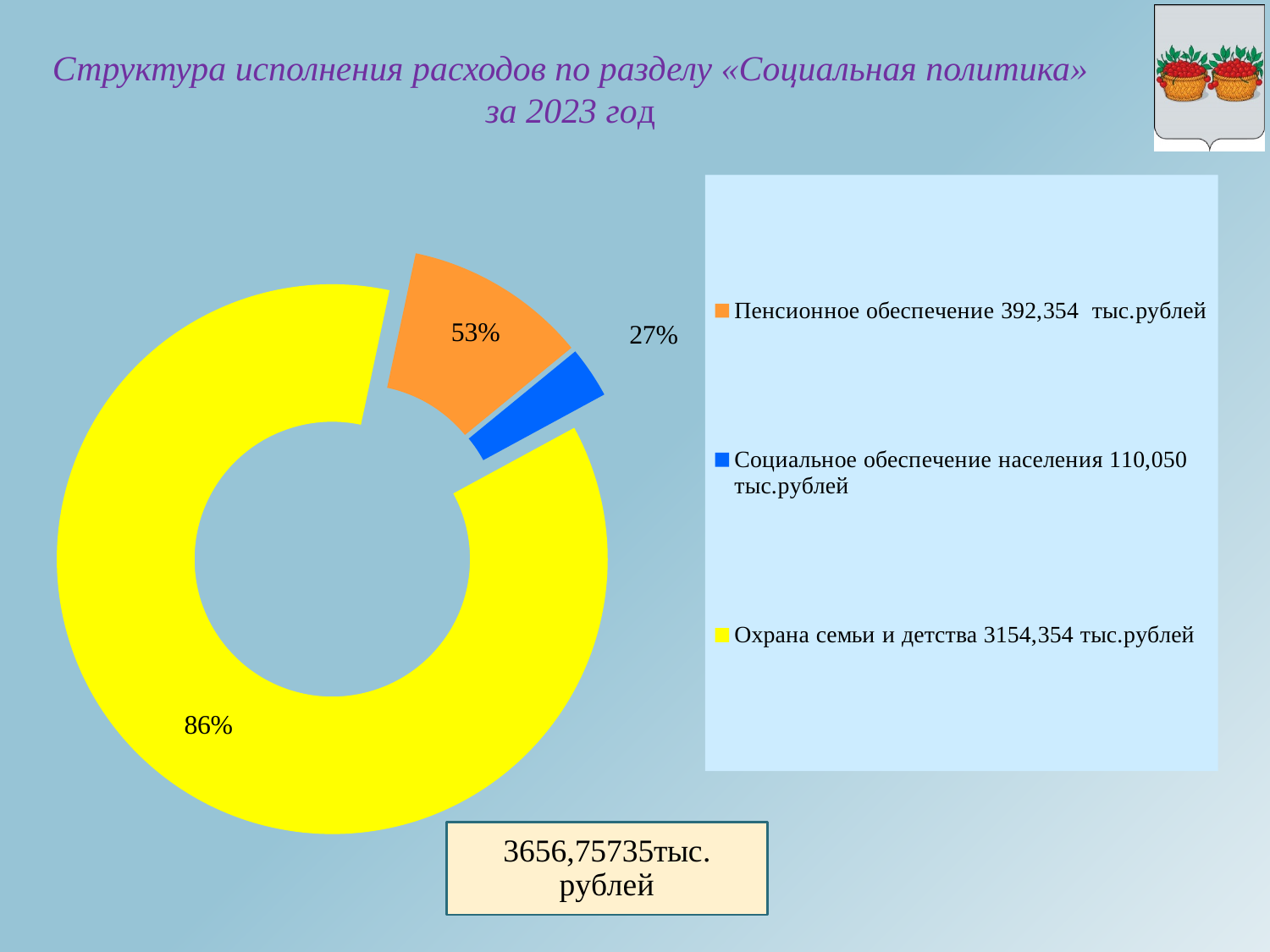
Which category has the smallest value? Социальное обеспечение населения What colour represents Пенсионное обеспечение in the chart? Orange What value is given in the legend for Пенсионное обеспечение? 392,354 тыс.рублей What percentage label is printed on the yellow slice (Охрана семьи и детства)? 86% What value is given in the legend for Социальное обеспечение населения? 110,050 тыс.рублей What value is given in the legend for Охрана семьи и детства? 3154,354 тыс.рублей Which category has the largest value? Охрана семьи и детства What total amount is shown in the box below the chart? 3656,75735тыс. рублей How many categories does the chart's legend list? 3 Which is larger: Пенсионное обеспечение or Социальное обеспечение населения? Пенсионное обеспечение What kind of chart is shown on the slide? Doughnut (pie) chart What colour represents Охрана семьи и детства in the chart? Yellow